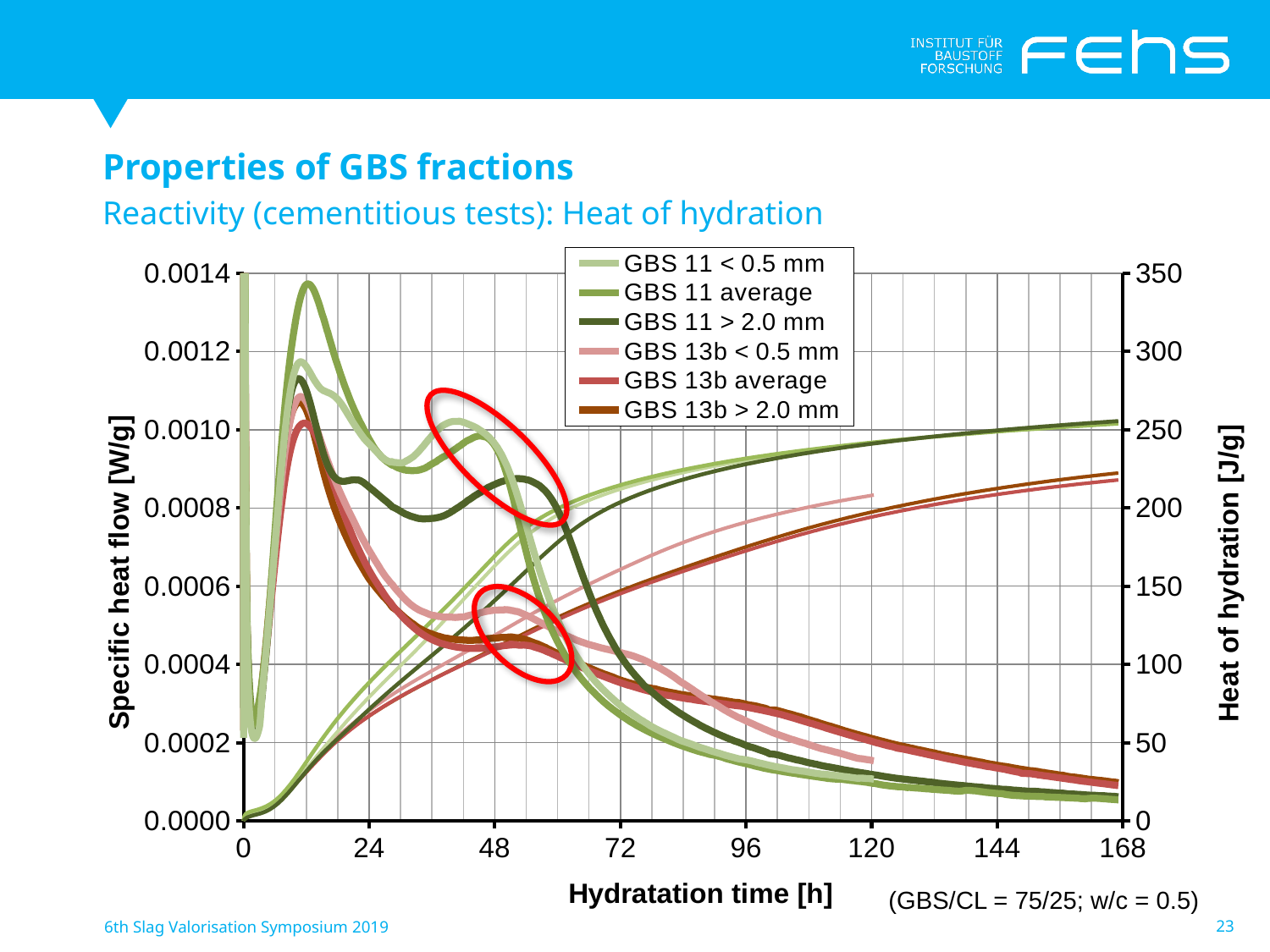
Between 72 h and 168 h, does the specific heat flow for GBS 11 average rise or fall? fall At 168 h, is the heat of hydration for GBS 11 > 2.0 mm greater or less than 200 J/g? greater What is the first entry listed in the chart legend? GBS 11 < 0.5 mm How many series does the chart legend list? 6 What is the title of the x axis of the chart? Hydratation time [h] What kind of chart is shown on the slide? line chart At 168 h, is the heat of hydration for GBS 13b > 2.0 mm greater or less than 250 J/g? less Is the peak specific heat flow for GBS 11 average greater or less than 0.0012 W/g? greater Do the heat of hydration curves rise or fall as hydration time increases? rise Which series reaches the highest peak specific heat flow? GBS 11 average At 168 h, which series has the higher heat of hydration, GBS 11 average or GBS 13b average? GBS 11 average